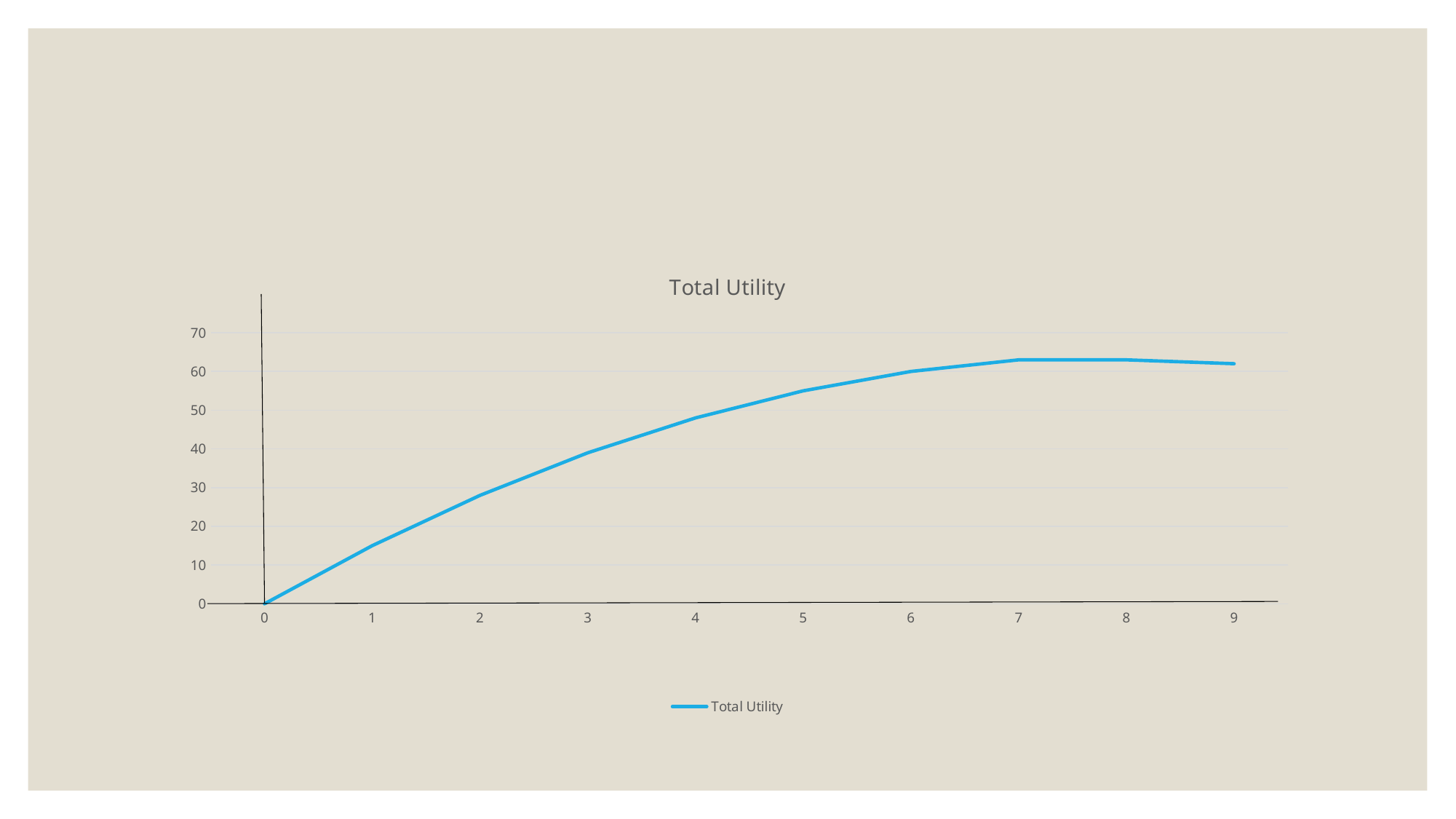
Is the value of Total Utility at x = 3 greater or less than 30? greater Is the value of Total Utility at x = 7 greater or less than 60? greater Does Total Utility rise or fall between x = 0 and x = 7? rise What is the title of the chart? Total Utility How many series does the legend list? 1 At which x value is Total Utility lowest? 0 How many points are plotted on the Total Utility line? 10 What kind of chart is shown on the slide? line chart Which is larger, Total Utility at x = 3 or at x = 6? x = 6 What is the value of Total Utility at x = 0? 0 Is the value of Total Utility at x = 5 greater or less than 50? greater